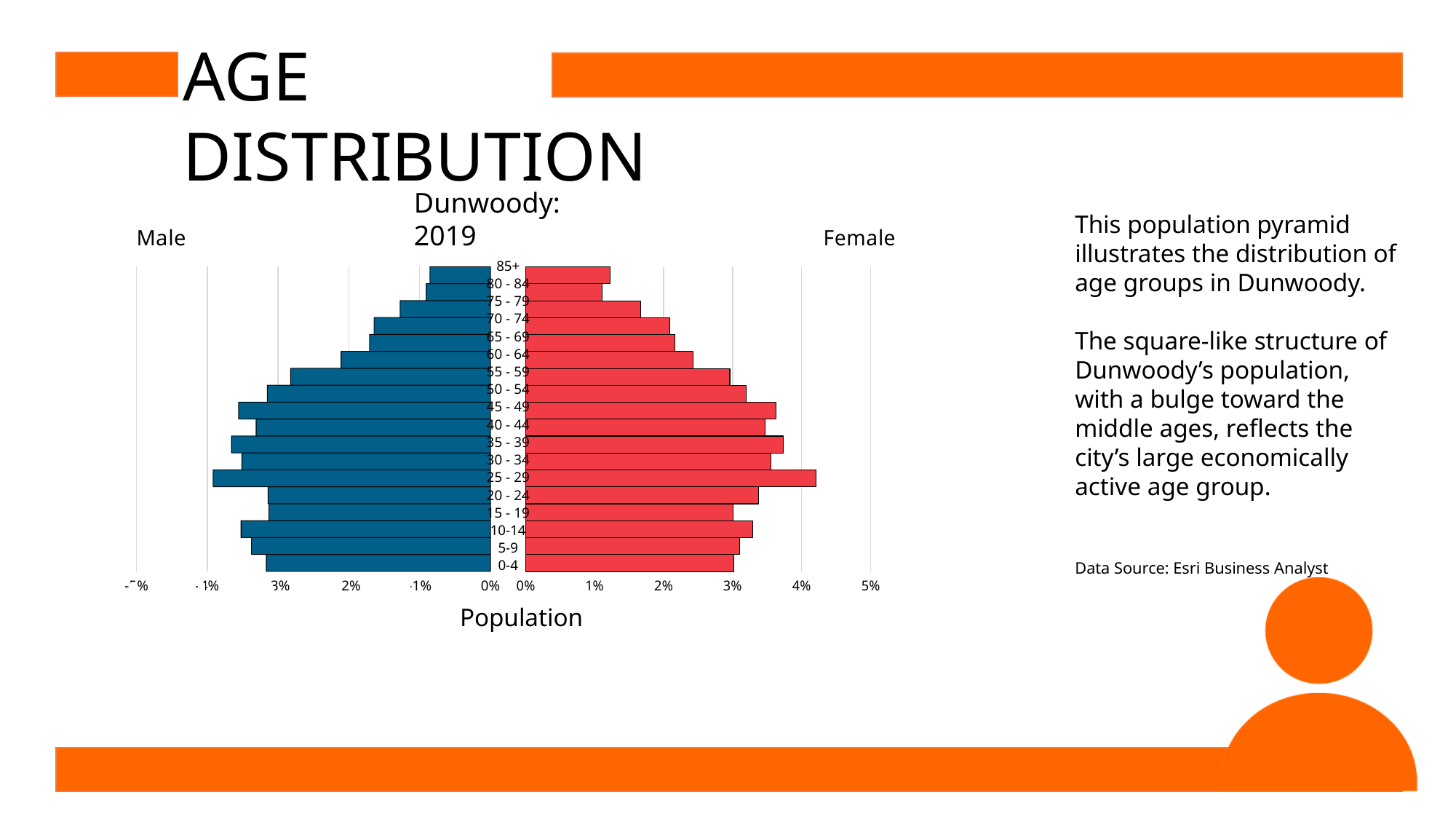
Is the Male value for the 85+ age group greater or less than 1%? less Which age group has the highest value on the Male side of the pyramid? 25 - 29 How many age groups are plotted in the population pyramid? 18 Which age group has the highest value on the Female side of the pyramid? 25 - 29 Is the Female value for the 45 - 49 age group greater or less than 3%? greater For the 25 - 29 age group, which is larger, the Male value or the Female value? Female Is the Female value for the 35 - 39 age group greater or less than 4%? less What is the title of the chart? Dunwoody: 2019 What is the label on the horizontal axis of the chart? Population What kind of chart is shown on the slide? bar chart